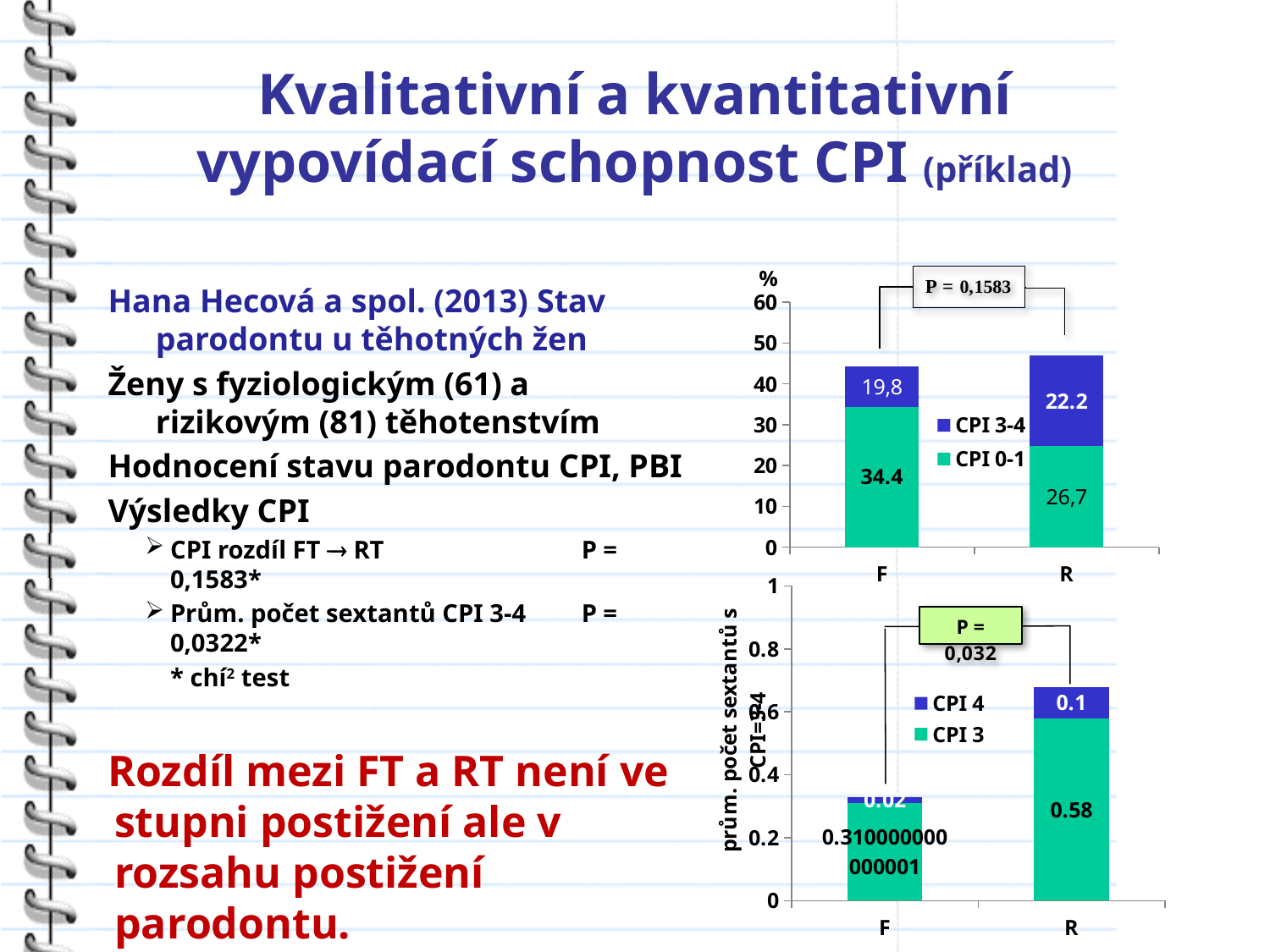
In the top chart, what is the value of CPI 3-4 for category R? 22.2 In the bottom chart, what is the value of CPI 4 for category F? 0.02 In the top chart, how many series does the legend list? 2 In the top chart, what is the value of CPI 0-1 for category F? 34.4 In the bottom chart, what is the value of CPI 3 for category R? 0.58 In the top chart, what is the value of CPI 0-1 for category R? 26,7 In the bottom chart, how many categories are shown on the x axis? 2 In the top chart, what is the difference between the CPI 3-4 values for R and F? 2.4 In the top chart, which category has the larger CPI 0-1 value, F or R? F What kind of chart is the top chart? Stacked bar chart What P value is shown in the annotation above the bars in the top chart? P = 0,1583 In the bottom chart, what is the total of the stacked bar for category R? 0.68